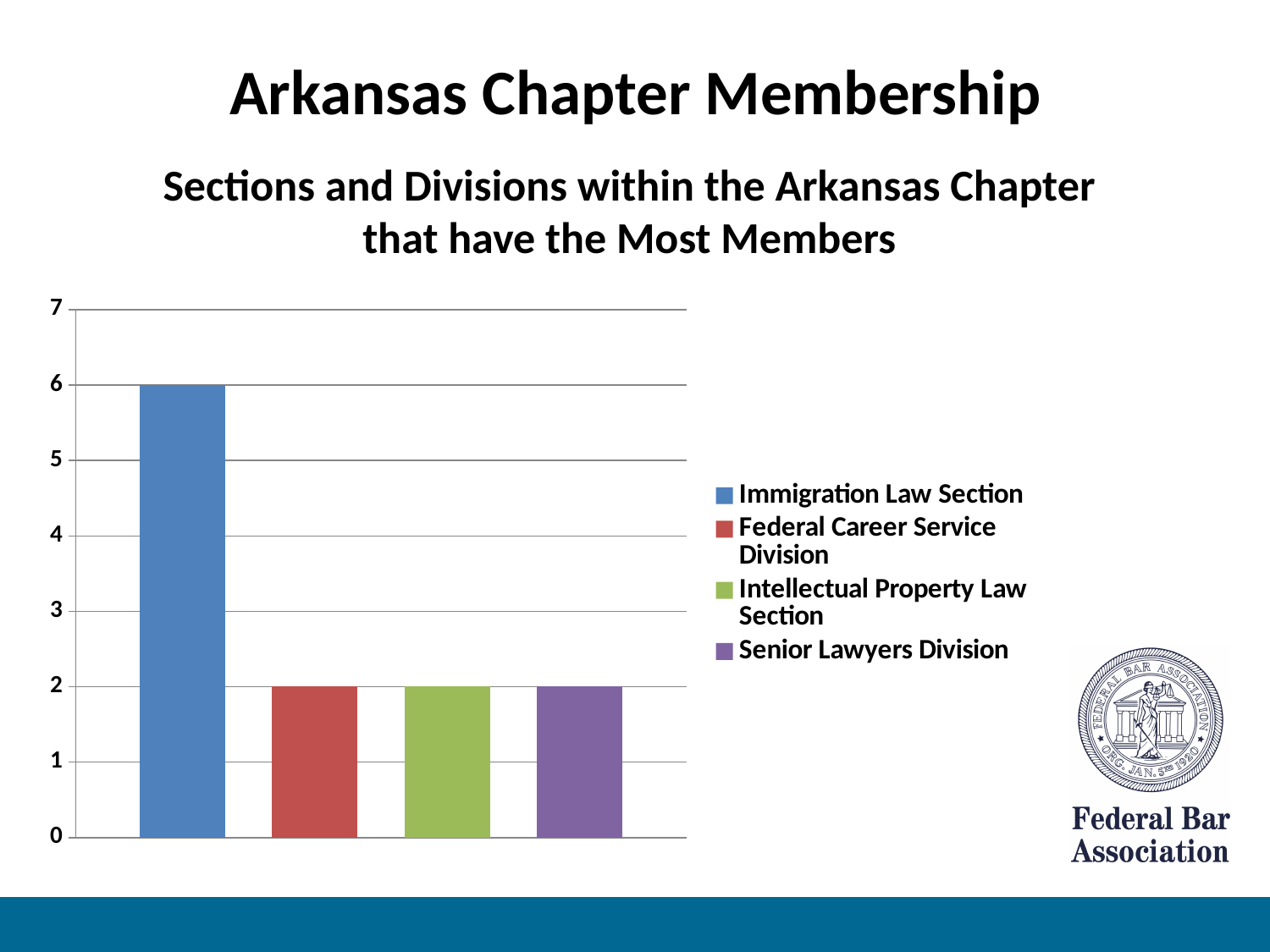
What kind of chart is shown on the slide? Bar chart How many entries does the legend list? 4 What is the difference between the Immigration Law Section and the Intellectual Property Law Section? 4 What colour is the bar for the Intellectual Property Law Section? Green What is the value for the Federal Career Service Division? 2 What is the value for the Immigration Law Section? 6 How many bars are plotted in the chart? 4 Which is larger, the Immigration Law Section or the Senior Lawyers Division? Immigration Law Section Is the value for the Immigration Law Section greater or less than 5? greater Which section or division has the highest value? Immigration Law Section Is the value for the Intellectual Property Law Section greater or less than 3? less What is the value for the Senior Lawyers Division? 2